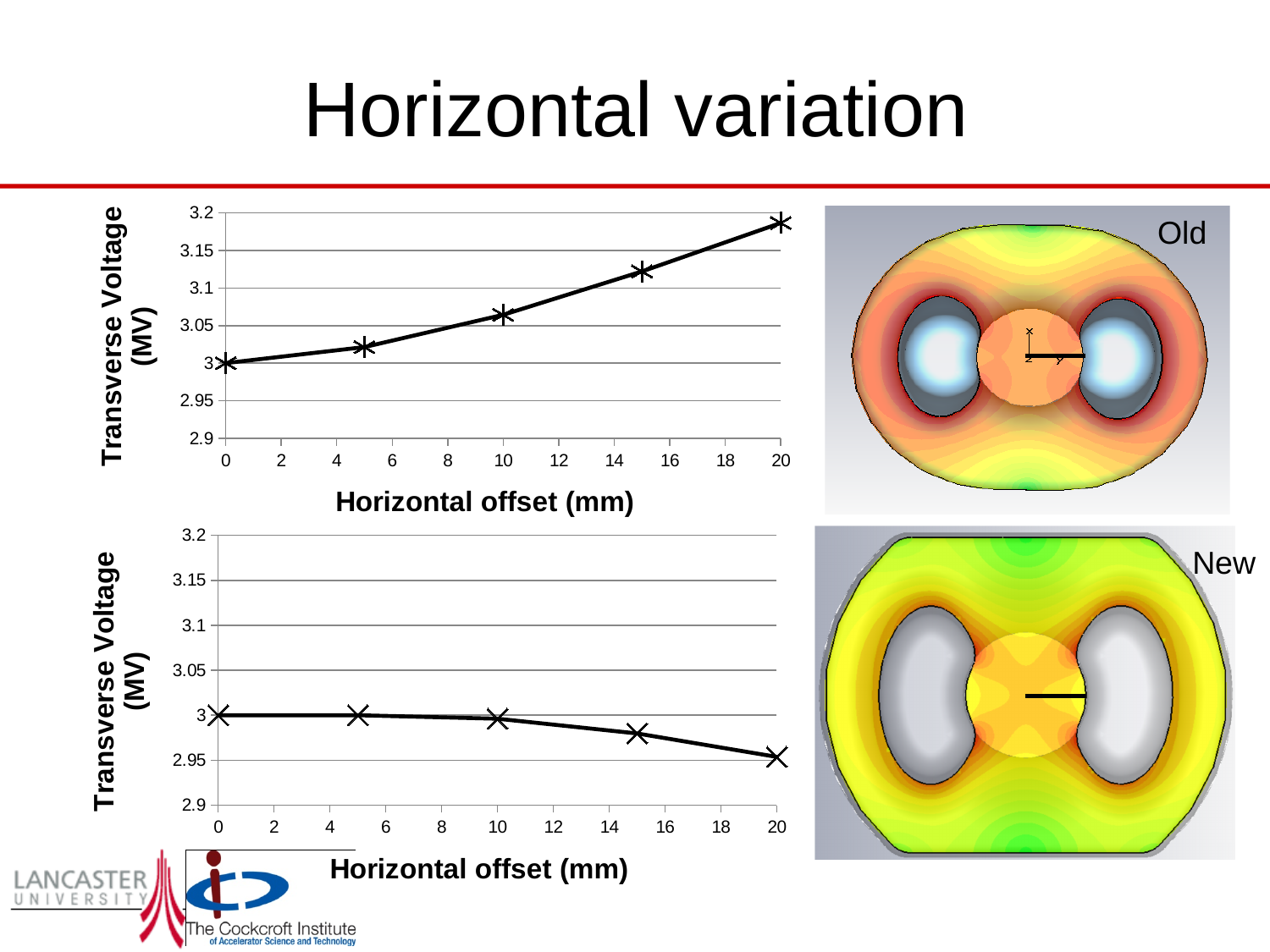
In the top chart, is the transverse voltage at a horizontal offset of 20 mm greater or less than 3.15? greater What kind of chart is the top chart on the slide? line chart In the top chart, is the transverse voltage at a horizontal offset of 10 mm greater or less than 3.05? greater In the top chart, does the transverse voltage rise or fall as the horizontal offset increases? rise In the top chart, at which horizontal offset is the transverse voltage highest? 20 In the bottom chart, at which horizontal offset is the transverse voltage lowest? 20 In the bottom chart, is the transverse voltage at a horizontal offset of 20 mm greater or less than 3? less In the top chart, at which horizontal offset is the transverse voltage lowest? 0 Which is larger: the transverse voltage at 20 mm in the top chart or at 20 mm in the bottom chart? top chart What is the x-axis title of the bottom chart? Horizontal offset (mm) In the top chart, how many data points are plotted? 5 In the bottom chart, does the transverse voltage rise or fall as the horizontal offset increases? fall